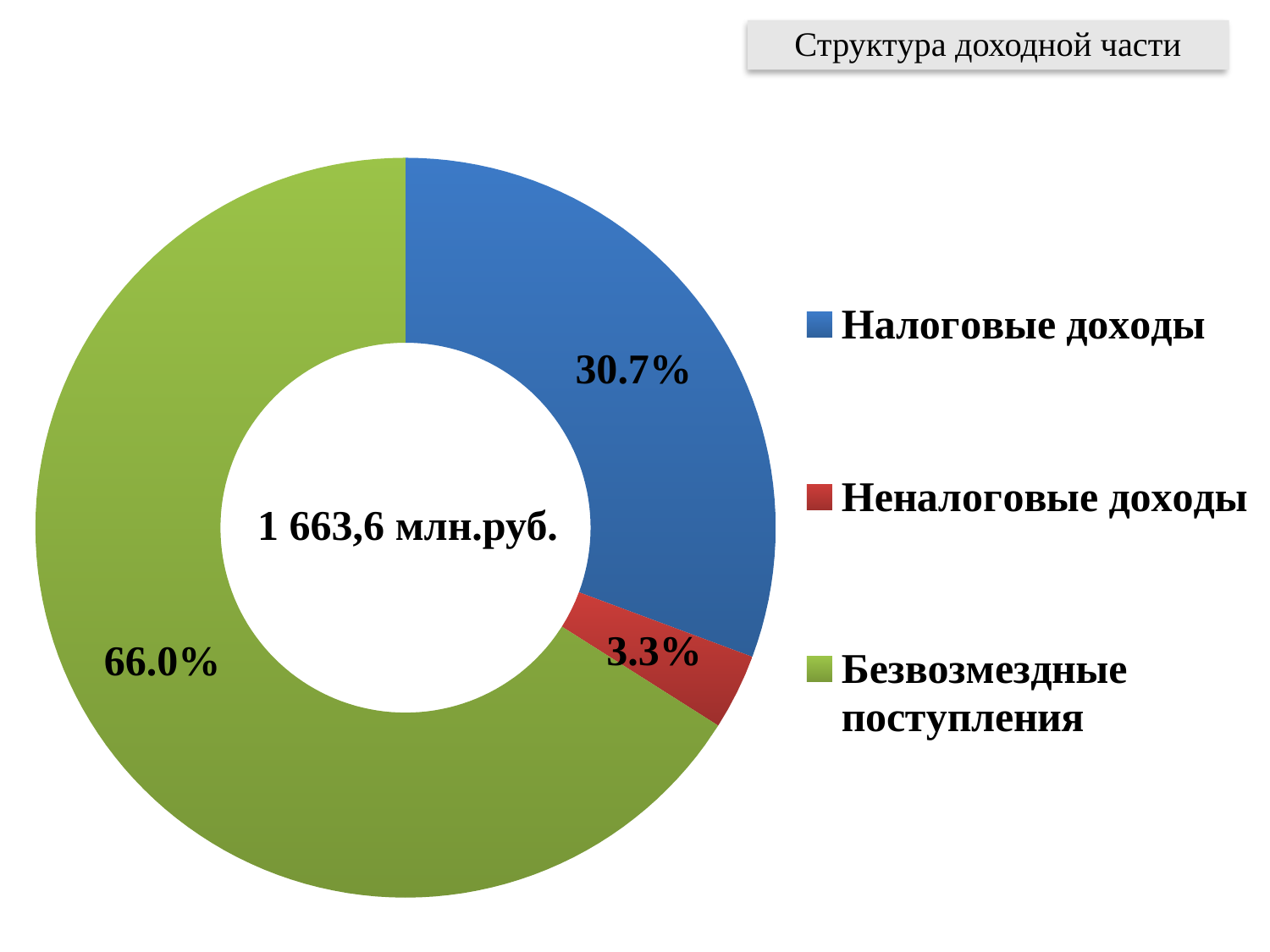
What is the difference in percentage points between Безвозмездные поступления and Налоговые доходы? 35.3 What share of the chart does Налоговые доходы represent? 30.7% How many categories does the chart show? 3 What colour represents Безвозмездные поступления in the chart? Green Which category has the largest share? Безвозмездные поступления What share of the chart does Безвозмездные поступления represent? 66.0% What total value is printed in the centre of the chart? 1 663,6 млн.руб. Which category has the smallest share? Неналоговые доходы Which is larger, Налоговые доходы or Неналоговые доходы? Налоговые доходы What share of the chart does Неналоговые доходы represent? 3.3% What kind of chart is shown on the slide? Doughnut (pie) chart What is the difference in percentage points between Налоговые доходы and Неналоговые доходы? 27.4